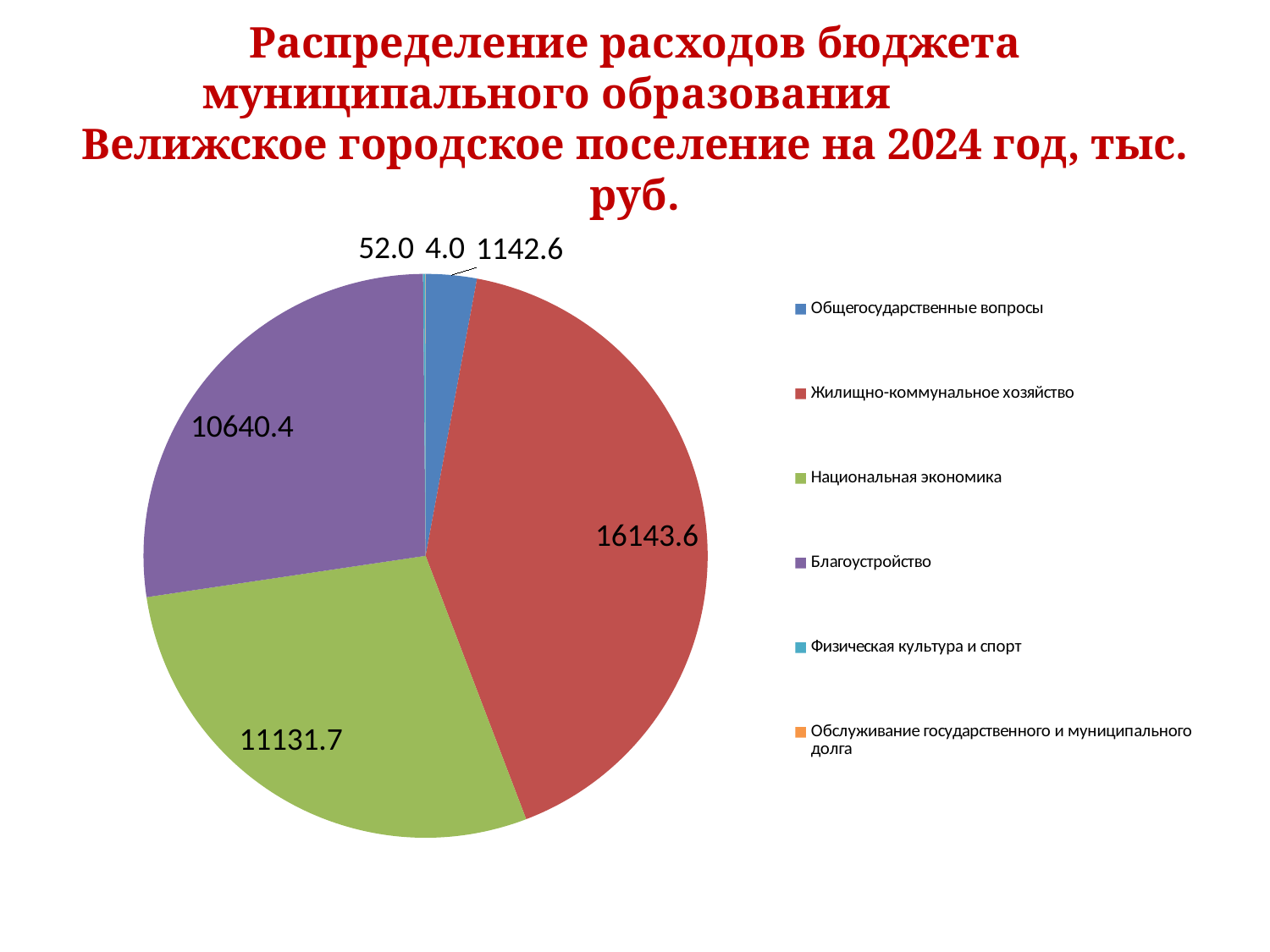
What is the value for Жилищно-коммунальное хозяйство? 16143.6 What is the value for Благоустройство? 10640.4 What type of chart is shown on the slide? Pie chart What is the value for Обслуживание государственного и муниципального долга? 4.0 Which category has the largest share of the pie? Жилищно-коммунальное хозяйство What is the value for Общегосударственные вопросы? 1142.6 What is the difference between the values for Жилищно-коммунальное хозяйство and Национальная экономика? 5011.9 Which category has the smallest value? Обслуживание государственного и муниципального долга Which is larger: Национальная экономика or Благоустройство? Национальная экономика What is the value for Национальная экономика? 11131.7 What colour is the slice for Благоустройство? Purple How many categories does the legend list? 6